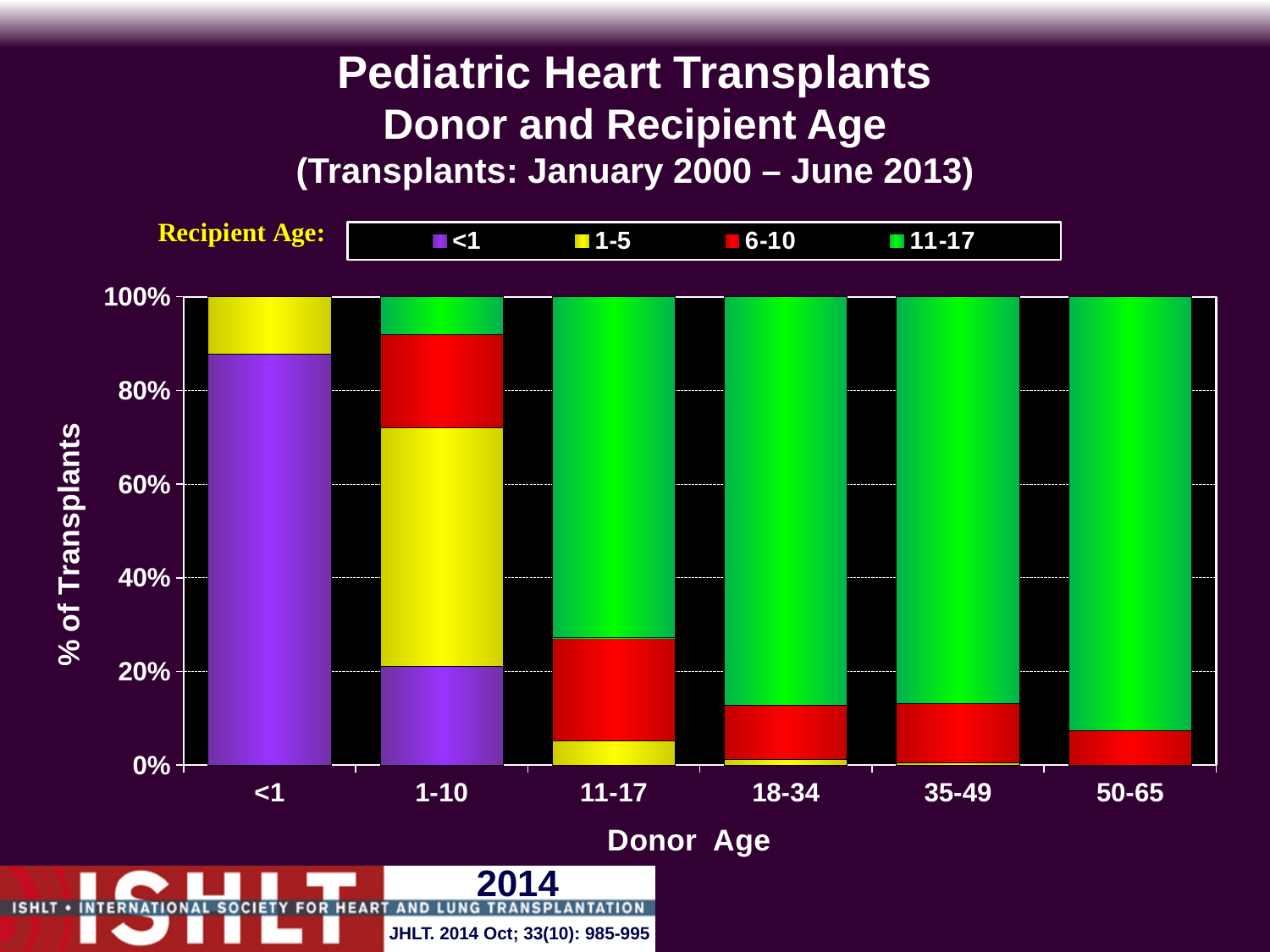
What kind of chart is shown on the slide? Stacked bar chart Is the share of 6-10 recipients for donor age 50-65 greater or less than 20%? less Is the share of 1-5 recipients for donor age 1-10 greater or less than 40%? greater What is the total height of each stacked bar? 100% What is the label of the x axis? Donor Age Which donor age group has the largest share of <1 recipients? <1 How many recipient age series does the legend list? 4 Is the share of <1 recipients for donor age <1 greater or less than 80%? greater How many donor age categories are shown on the x axis? 6 Which donor age group has the largest share of 11-17 recipients? 50-65 Is the share of 6-10 recipients larger for donor age 11-17 or donor age 50-65? 11-17